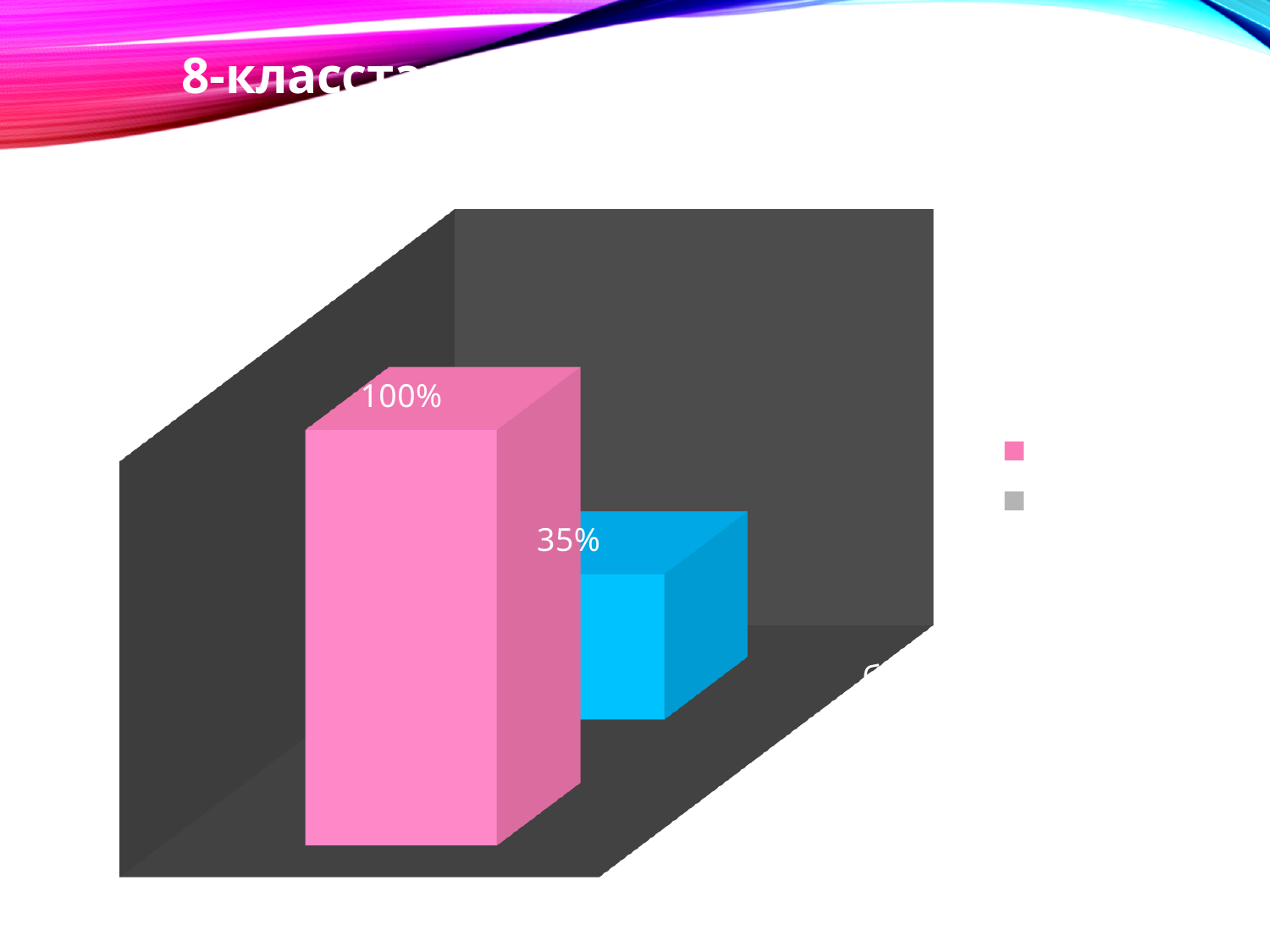
Is the value of the blue bar larger or smaller than the value of the pink bar? smaller What is the difference between the values of the pink bar and the blue bar? 65% What kind of chart is shown on the slide? bar chart What value is labelled on the pink bar? 100% Which bar has the highest value, the pink one or the blue one? the pink bar What colour is the tallest bar in the chart? pink How many entries does the legend list? 2 How many bars are plotted in the chart? 2 What value is labelled on the blue bar? 35% Which bar has the lowest value, the pink one or the blue one? the blue bar